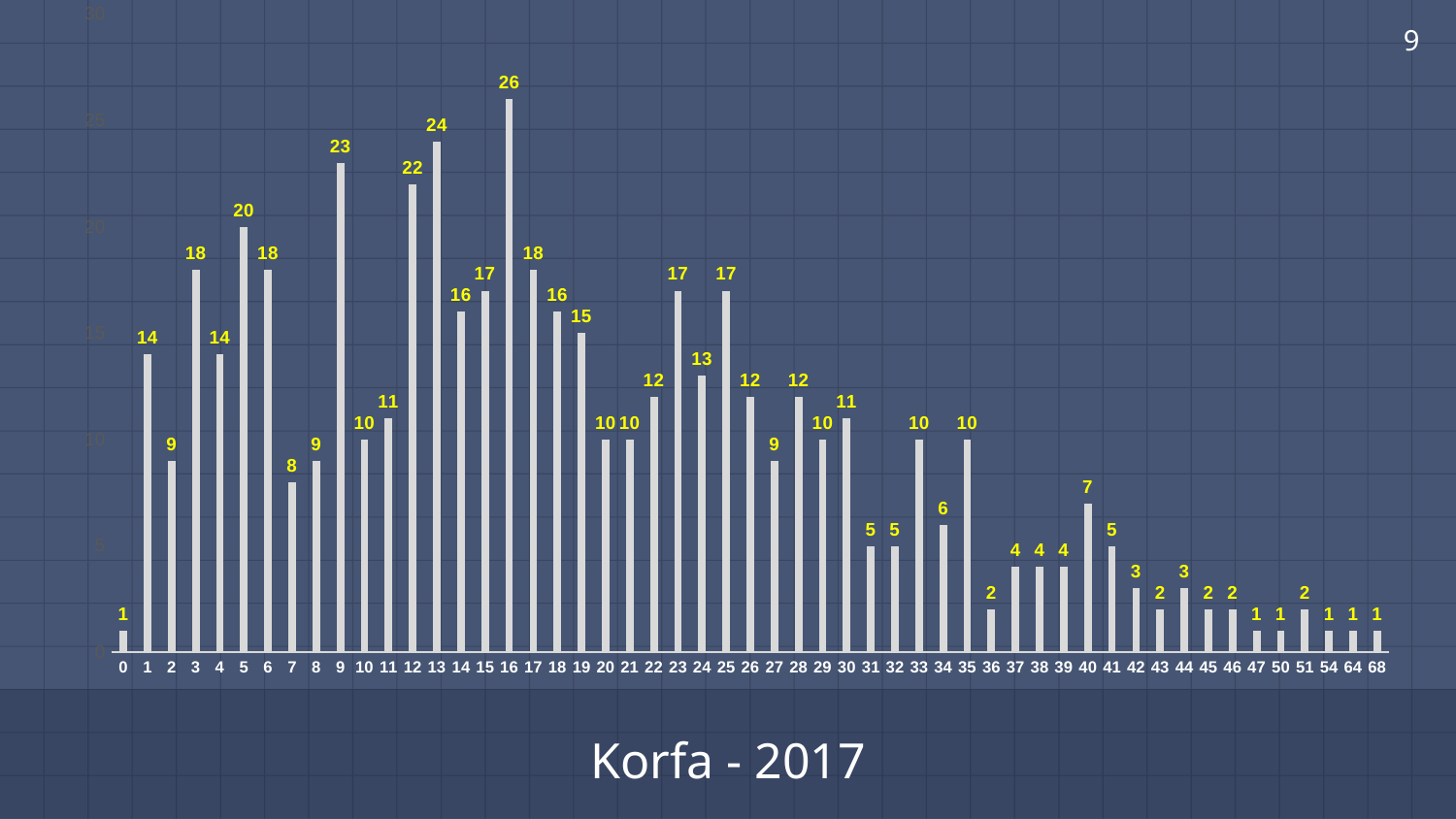
What is the difference between the values for category 13 and category 12? 2 What is the value for category 9? 23 What is the value for category 40? 7 What is the difference between the values for category 16 and category 5? 6 Which is larger, the value for category 23 or the value for category 24? category 23 Which is larger, the value for category 34 or the value for category 33? category 33 What type of chart is shown on the slide? bar chart Which category has the highest value? 16 What is the title of the chart? Korfa - 2017 How many categories are shown on the x axis? 53 What is the value for category 16? 26 What is the lowest value shown in the chart? 1